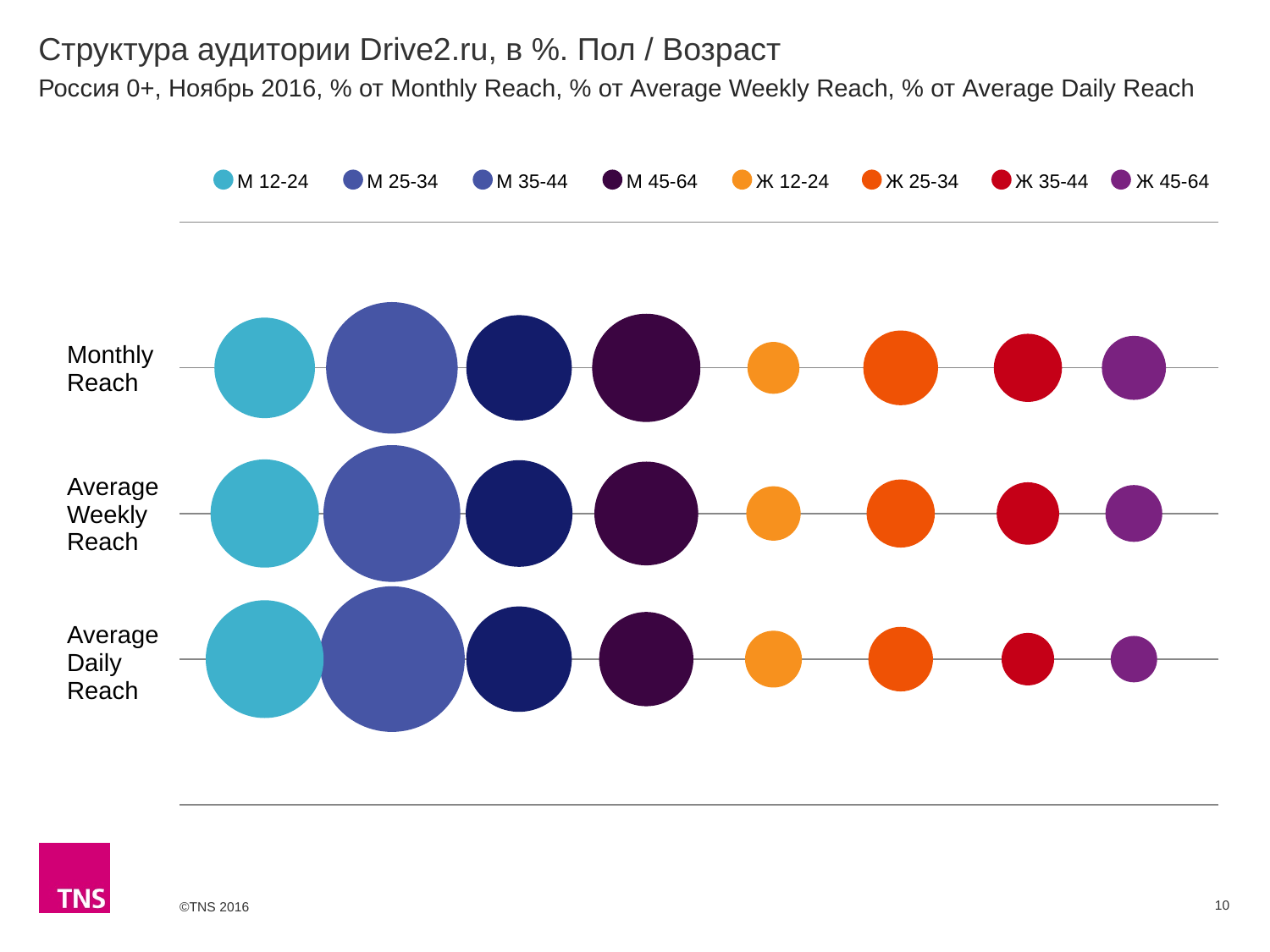
How many reach categories (rows) are plotted on the chart? 3 What is the title of the chart on the slide? Структура аудитории Drive2.ru, в %. Пол / Возраст In the Average Weekly Reach row, which bubble is larger: Ж 25-34 or Ж 12-24? Ж 25-34 Does the Ж 45-64 bubble get larger or smaller going from Monthly Reach to Average Daily Reach? Smaller Which gender/age group has the smallest bubble in the Average Daily Reach row? Ж 45-64 In the Monthly Reach row, which bubble is larger: М 45-64 or Ж 45-64? М 45-64 How many series does the legend list? 8 Which gender/age group has the largest bubble in the Average Daily Reach row? М 25-34 Which gender/age group has the largest bubble in the Monthly Reach row? М 25-34 In the Monthly Reach row, which bubble is larger: М 25-34 or М 12-24? М 25-34 What kind of chart is shown on the slide? Bubble chart Which legend entry is shown in red? Ж 35-44